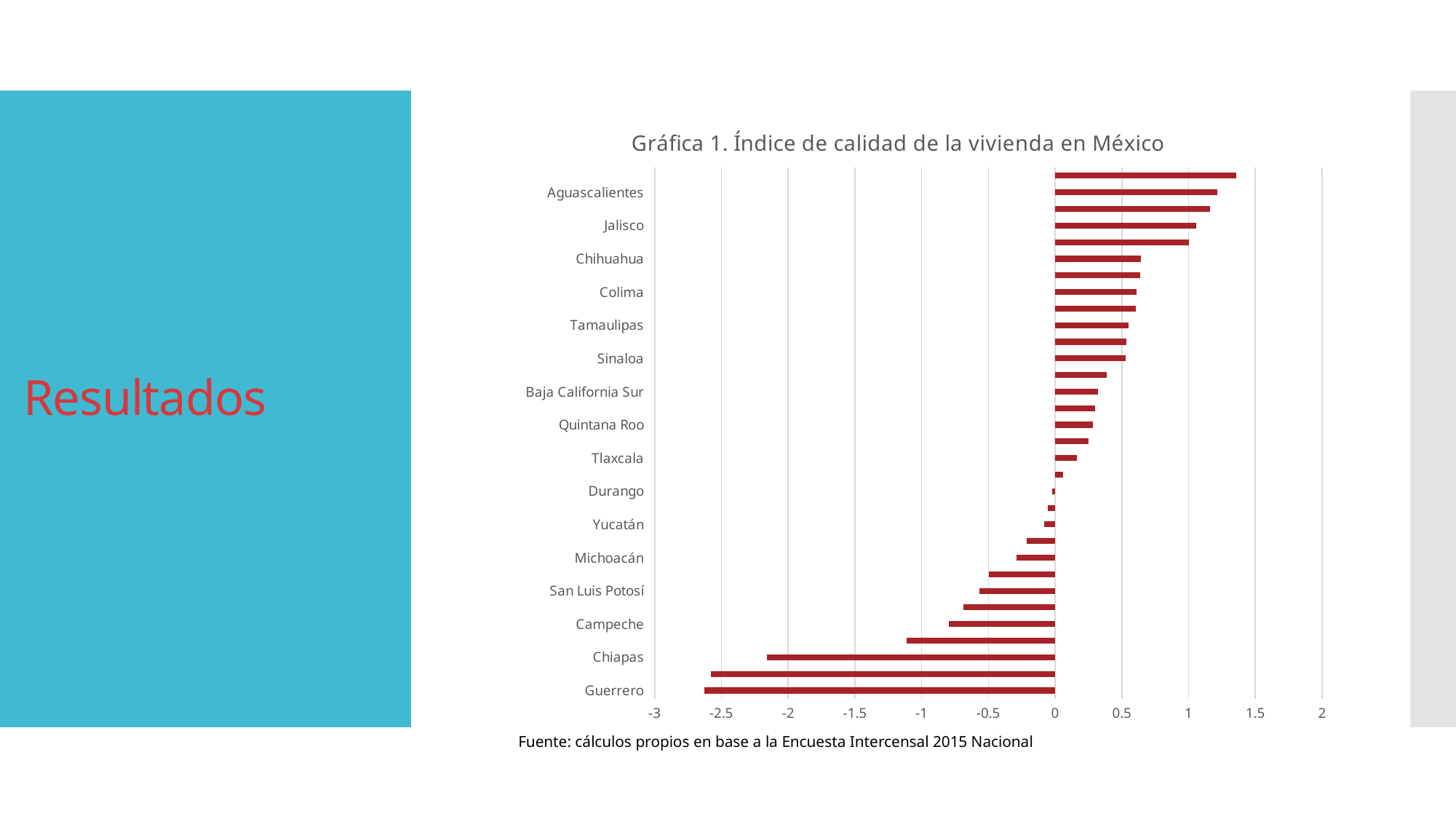
Is the value for Aguascalientes greater or less than 1? greater Is the value for Baja California Sur greater or less than 0.5? less Is the value for Chiapas greater or less than -2? less Which has the larger value, Chiapas or Campeche? Campeche Among the states labeled on the vertical axis, which has the highest value? Aguascalientes What type of chart is shown on the slide? Bar chart According to the note below the chart, what is the data source? Cálculos propios en base a la Encuesta Intercensal 2015 Nacional Which state has the lowest value in the chart? Guerrero Do the values rise or fall when reading the bars from top to bottom? fall What is the title of the chart? Gráfica 1. Índice de calidad de la vivienda en México